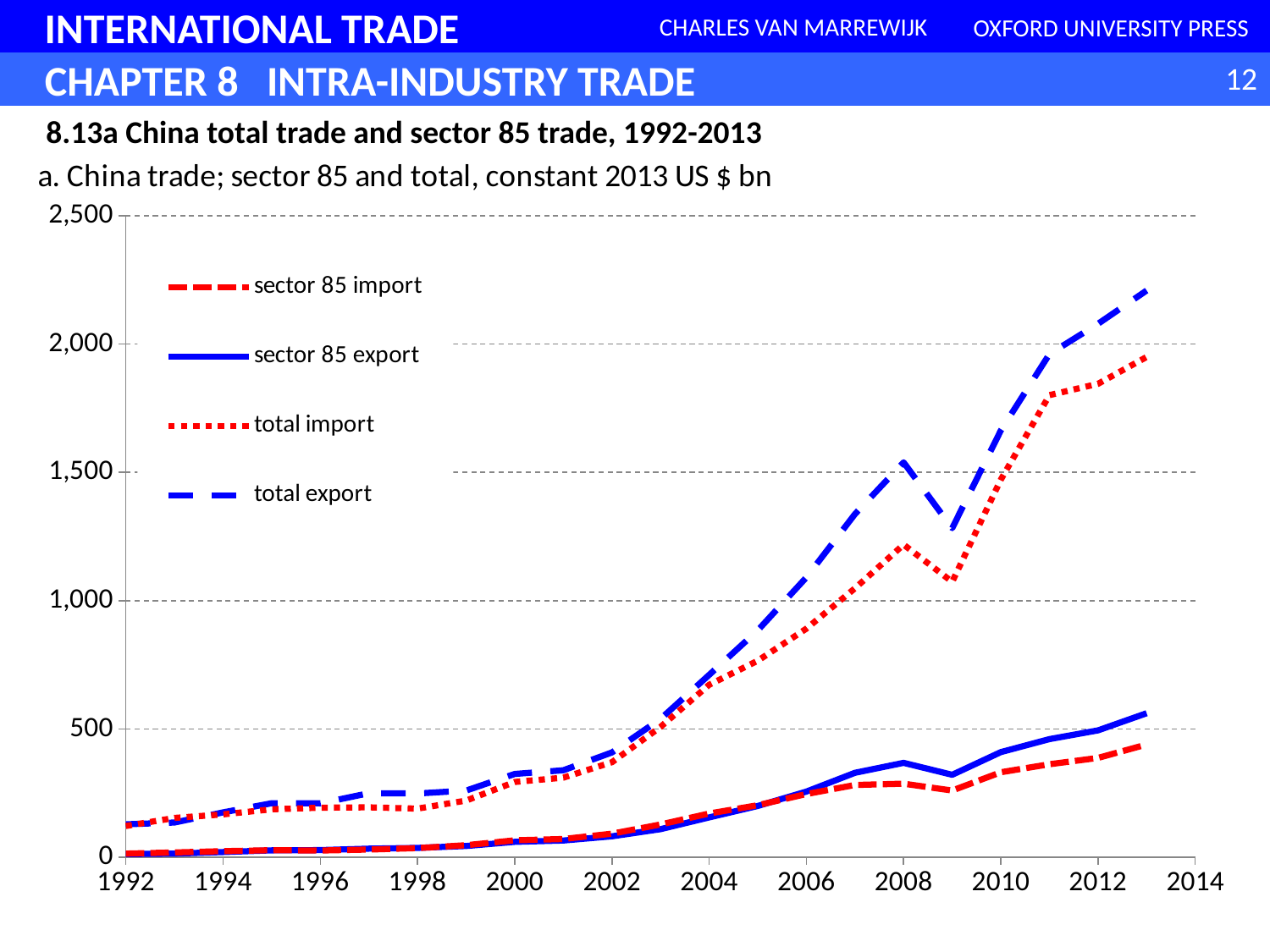
Does the total export series rise or fall overall from 1992 to 2013? rise What is the title printed above the chart? a. China trade; sector 85 and total, constant 2013 US $ bn Which series has the highest value in 2013? total export Is the value for total import in 2009 greater or less than 1,500? less What kind of chart is shown on the slide? line chart In 2013, which is larger: sector 85 export or sector 85 import? sector 85 export Is the value for total export in 2013 greater or less than 2,000? greater In 2008, which is larger: total export or total import? total export Is the value for total import in 2013 greater or less than 1,500? greater Which series has the lowest value in 2013? sector 85 import How many series does the legend list? 4